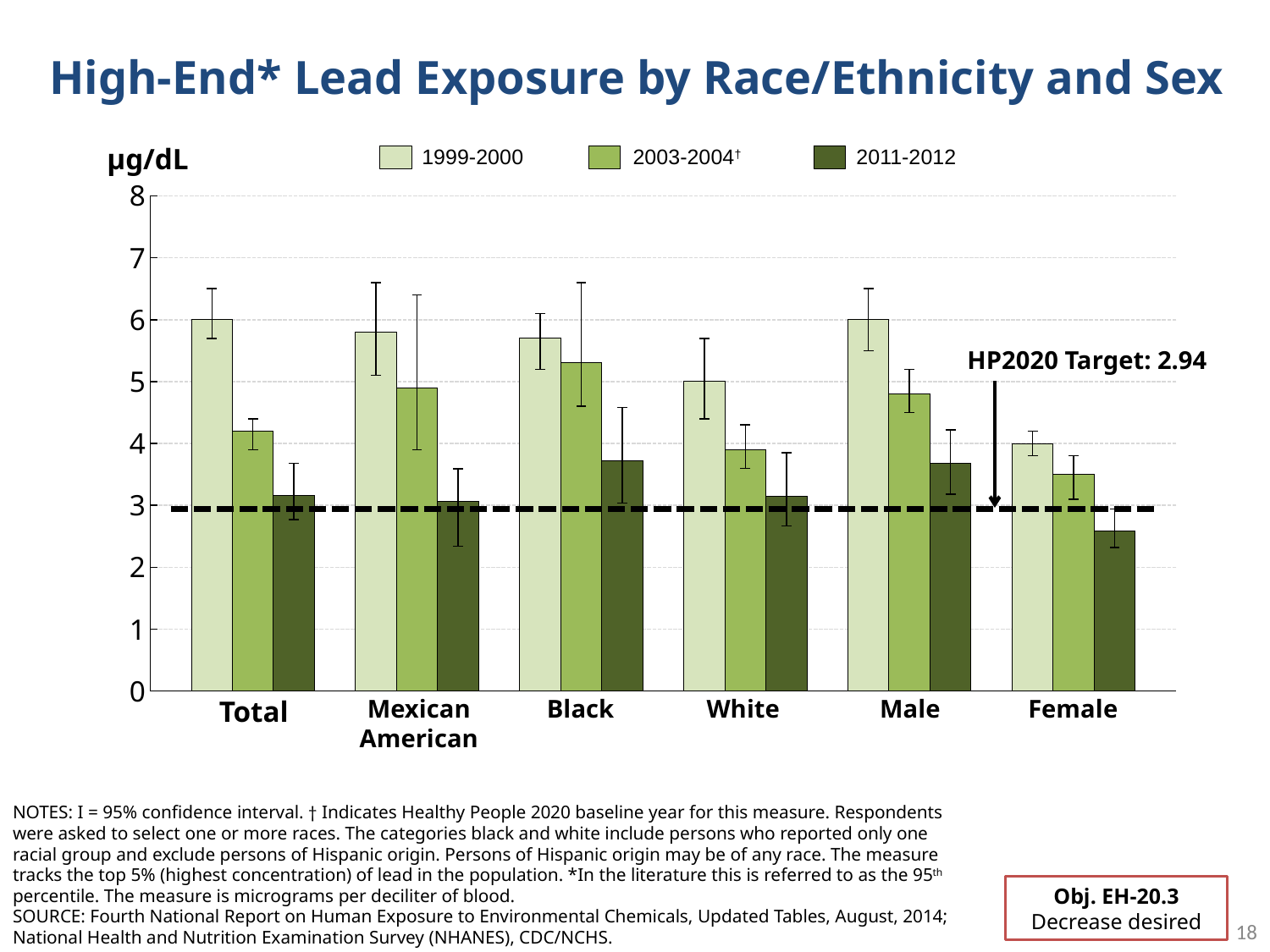
Which category has the lowest 2011-2012 value? Female How many series does the legend list? 3 How many race/ethnicity and sex categories are shown on the x axis? 6 Within each category, do the values rise or fall from 1999-2000 to 2011-2012? fall What kind of chart is shown on the slide? bar chart What is the HP2020 Target value shown on the chart? 2.94 Which is larger, the 2003-2004 value for Black or the 2003-2004 value for White? Black Is the 2003-2004 value for Male greater or less than 4? greater What unit is shown on the y axis of the chart? µg/dL Is the 2003-2004 value for Black greater or less than 5? greater Is the 2011-2012 value for Mexican American greater or less than 4? less